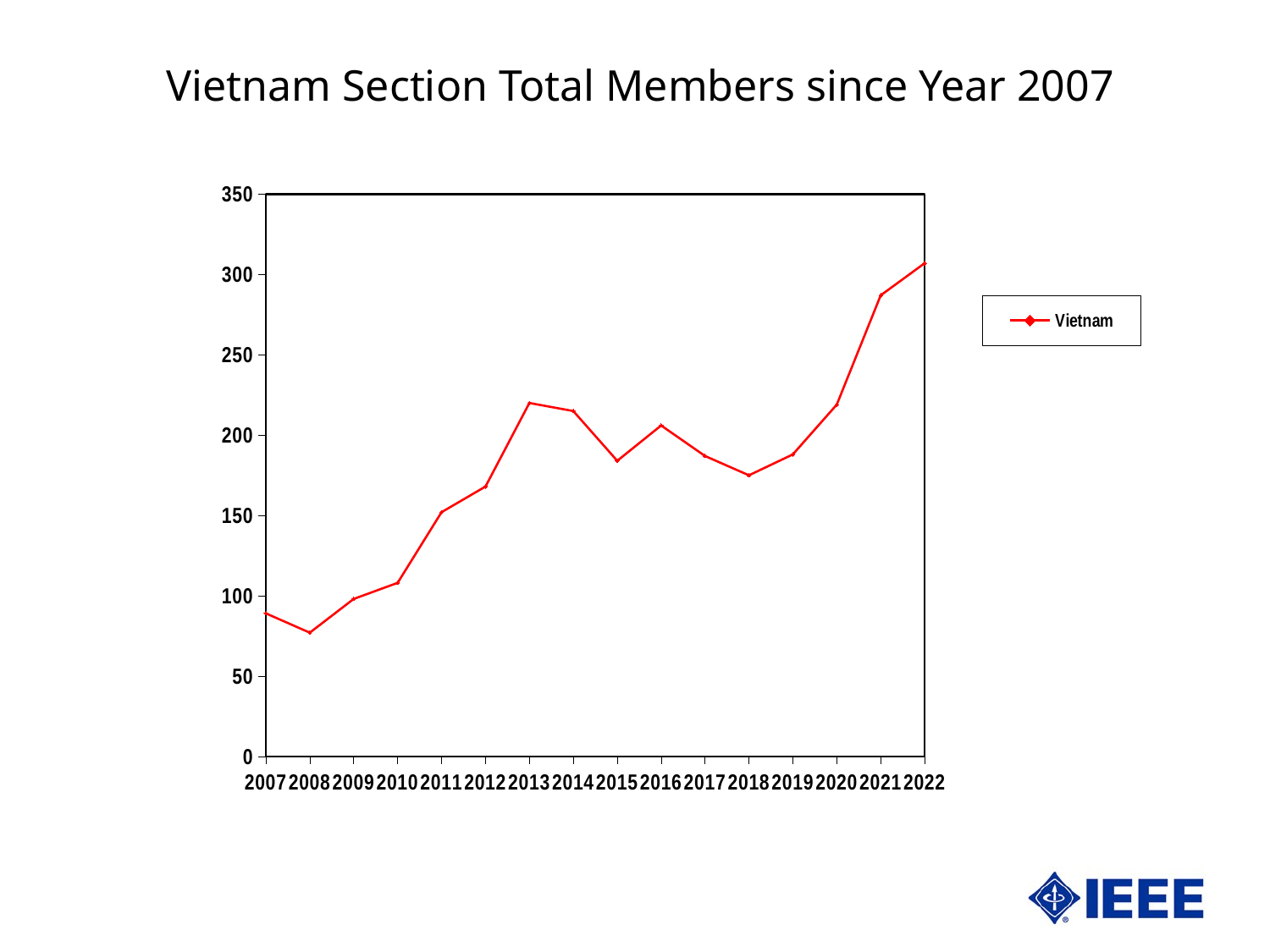
Do the values generally rise or fall from 2018 to 2022? rise What is the name of the series shown in the legend? Vietnam What kind of chart is shown on the slide? line chart Which year has more members, 2013 or 2018? 2013 How many years are plotted along the x axis? 16 Is the value for 2013 greater or less than 200? greater Is the value for 2008 greater or less than 100? less Is the value for 2022 greater or less than 300? greater How many series does the legend list? 1 Which year has the highest number of members? 2022 Which year has the lowest number of members? 2008